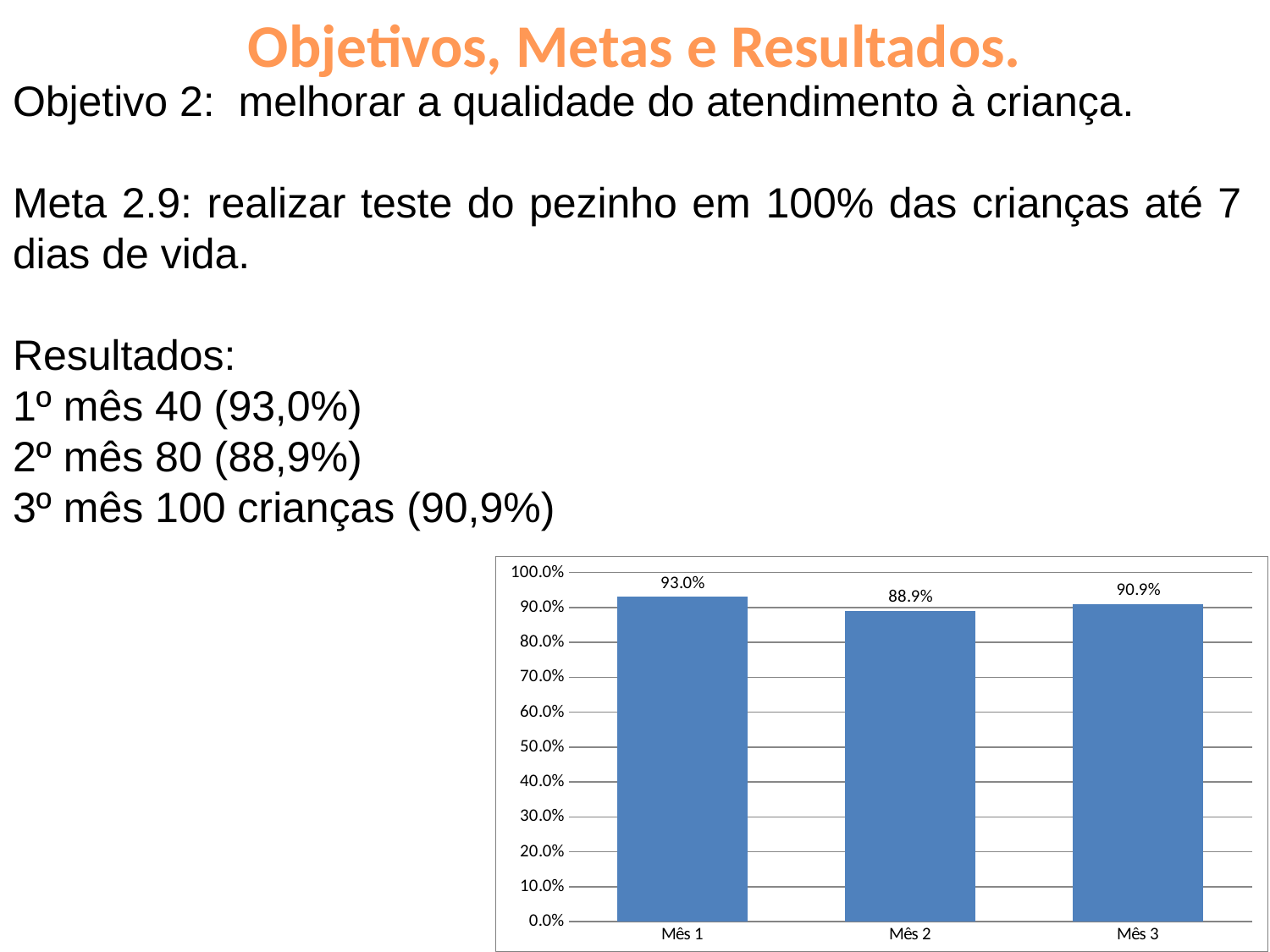
Which month has the lowest value? Mês 2 How many categories are shown on the x axis? 3 What is the value for Mês 2? 88.9% What is the value for Mês 3? 90.9% What is the difference between the values for Mês 3 and Mês 2? 2.0% Which is larger, the value for Mês 1 or the value for Mês 3? Mês 1 Is the value for Mês 2 greater or less than 90.0%? less What is the difference between the values for Mês 1 and Mês 2? 4.1% Which month has the highest value? Mês 1 What is the value for Mês 1? 93.0% What kind of chart is shown on the slide? bar chart What is the highest value shown on the y axis? 100.0%